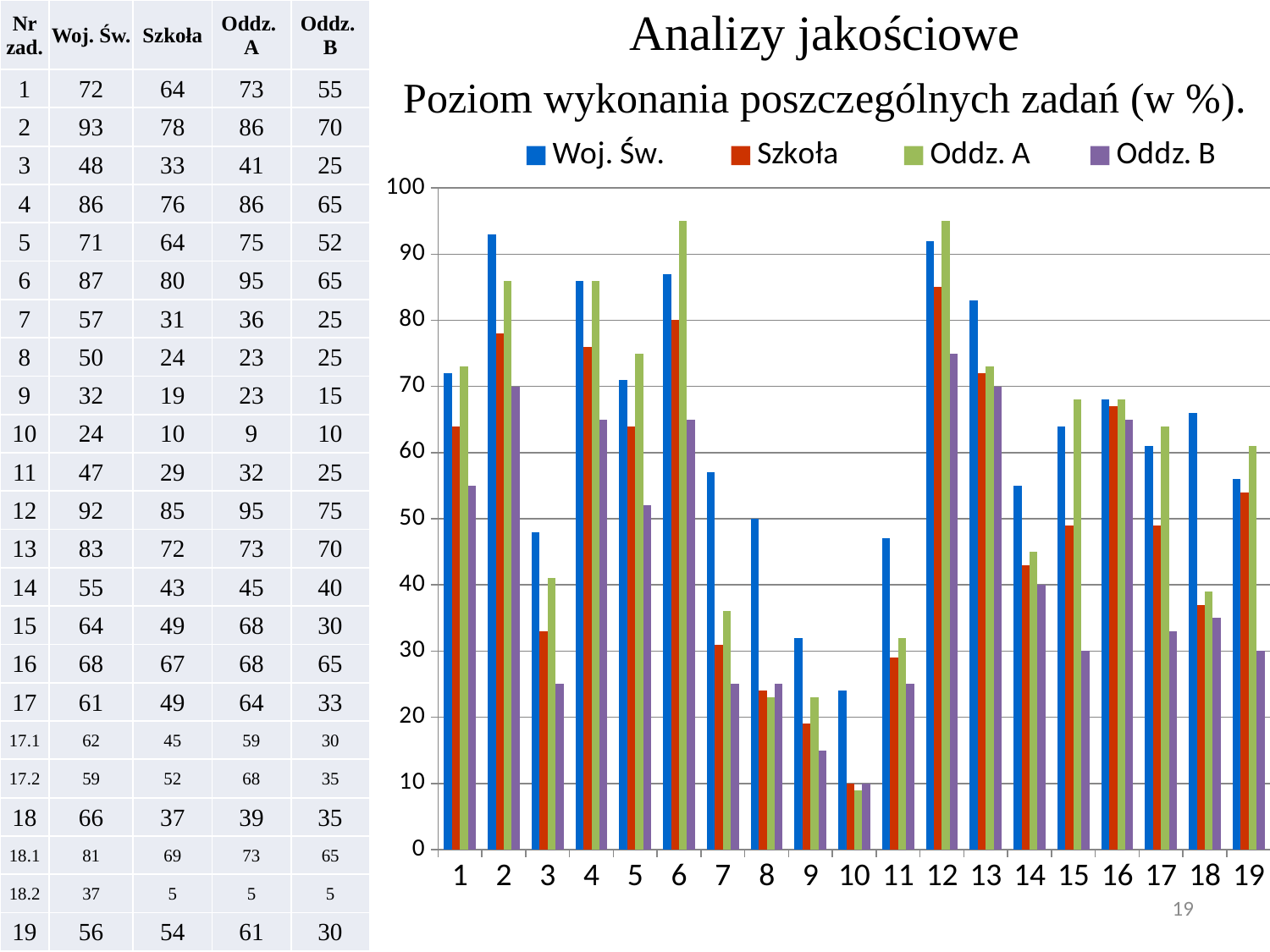
Do the Woj. Św. values rise or fall from task 7 to task 10? fall For task 8, which is larger: Woj. Św. or Szkoła? Woj. Św. Is the Szkoła value for task 6 greater or less than 70? greater What is the Woj. Św. value for task 2? 93 What is the Oddz. B value for task 15? 30 For task 12, what is the difference between the Woj. Św. value and the Oddz. B value? 17 How many series does the chart legend list? 4 Which colour represents Oddz. A in the chart legend? green What kind of chart is shown on the slide? bar chart For which task is the Woj. Św. value lowest? 10 For which task is the Oddz. A value lowest? 10 How many task numbers are shown along the x axis of the chart? 19